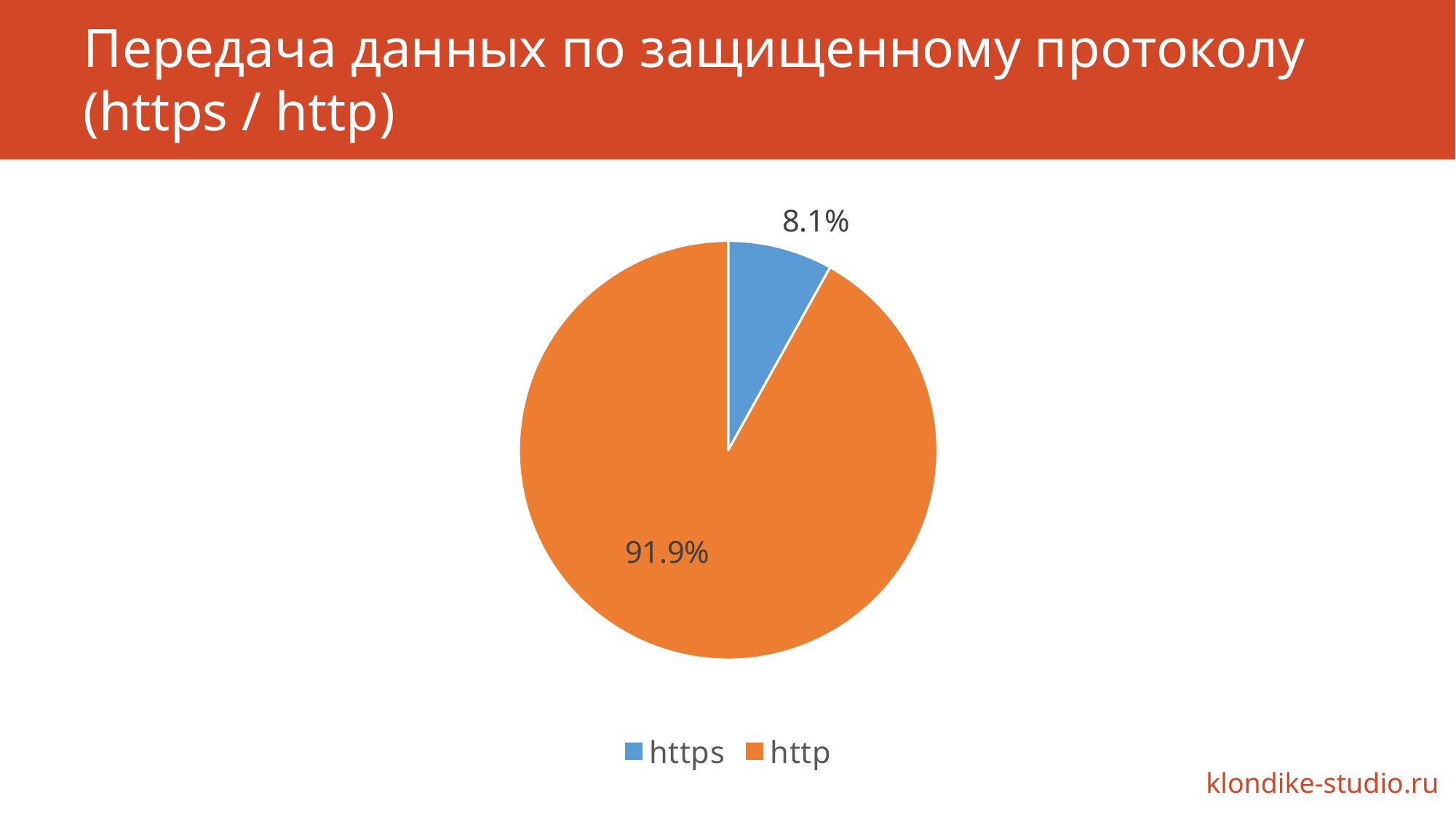
What is the total of the two slices shown on the pie chart? 100% What share of the pie does https have? 8.1% What share of the pie does http have? 91.9% What colour is the https slice? blue Which slice of the pie is the largest? http What is the difference in percentage points between the http and https slices? 83.8 Which slice of the pie is the smallest? https What kind of chart is shown on the slide? pie chart What colour is the http slice? orange How many slices does the pie chart have? 2 How many entries does the legend list? 2 Which is larger, the https slice or the http slice? http